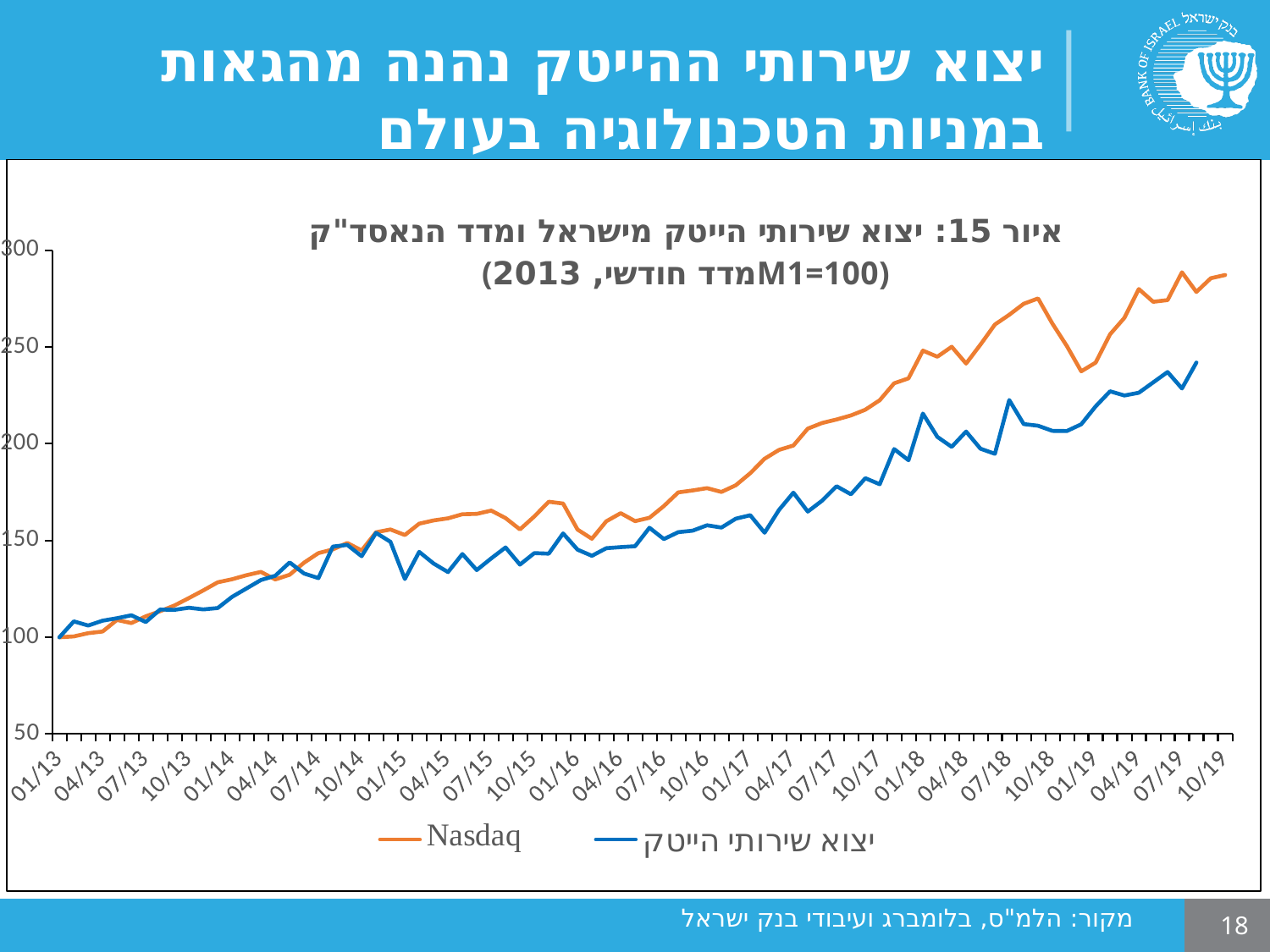
What is the title of the chart? איור 15: יצוא שירותי הייטק מישראל ומדד הנאסד"ק (מדד חודשי, 2013M1=100) Do the values of the Nasdaq series generally rise or fall from 01/13 to 10/19? rise What are the two series named in the legend? Nasdaq and יצוא שירותי הייטק Is the value of the Nasdaq series at 10/17 greater or less than 200? greater Is the value of the Nasdaq series at 10/19 greater or less than 250? greater How many series does the legend list? 2 What kind of chart is shown on the slide? line chart At 01/18, which series has the higher value, Nasdaq or יצוא שירותי הייטק? Nasdaq Do the values of the יצוא שירותי הייטק series generally rise or fall from 01/13 to 10/19? rise